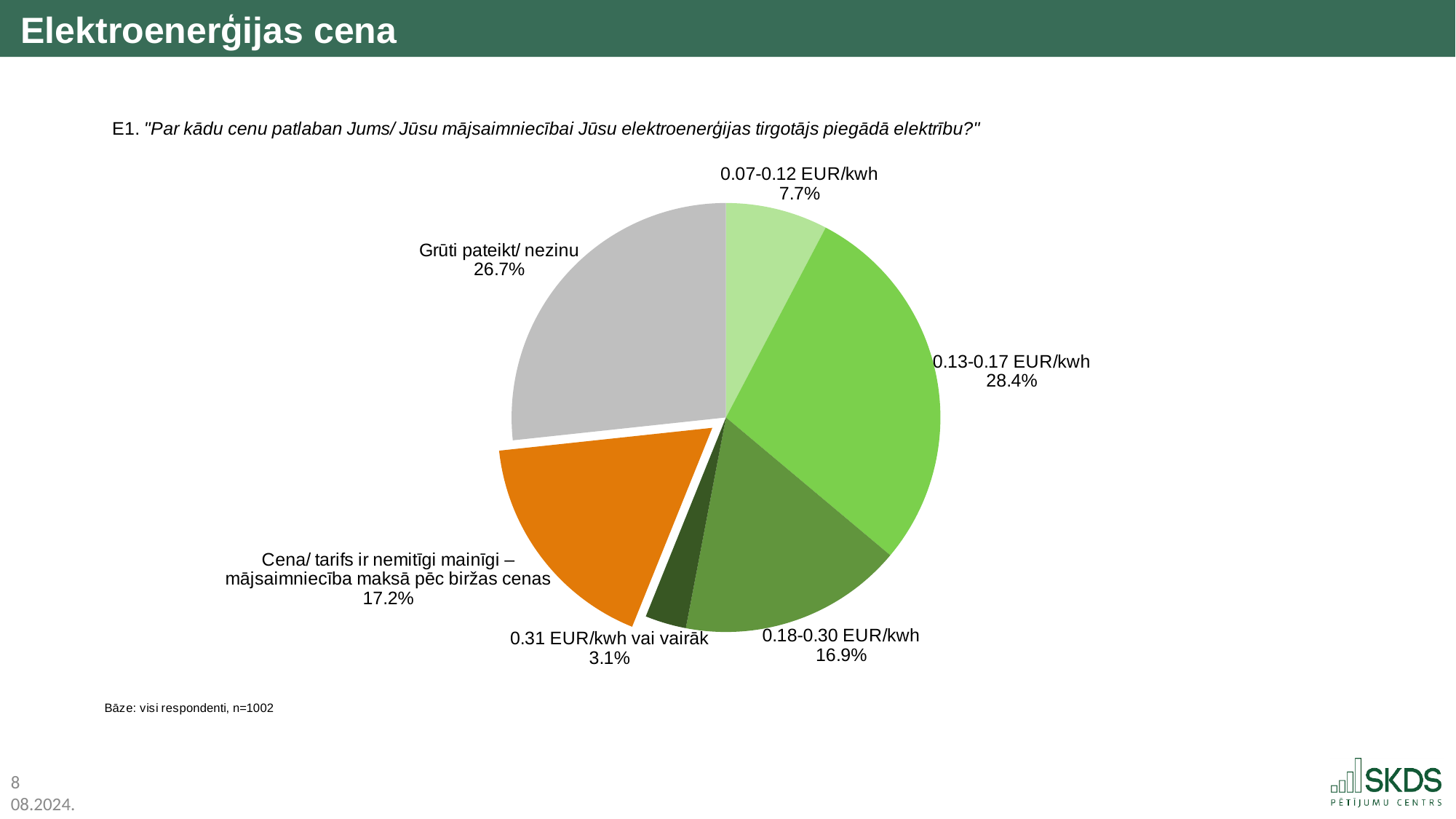
How many slices does the pie chart have? 6 Which category has the largest share of the pie? 0.13-0.17 EUR/kwh What share of respondents pay 0.31 EUR/kwh vai vairāk? 3.1% What share of respondents pay 0.13-0.17 EUR/kwh? 28.4% What type of chart is shown on the slide? Pie chart Which is larger: the share for 0.18-0.30 EUR/kwh or the share for 'Cena/ tarifs ir nemitīgi mainīgi – mājsaimniecība maksā pēc biržas cenas'? Cena/ tarifs ir nemitīgi mainīgi – mājsaimniecība maksā pēc biržas cenas What percentage of respondents pay 0.18-0.30 EUR/kwh? 16.9% Which category has the smallest share of the pie? 0.31 EUR/kwh vai vairāk What percentage of respondents answered 'Grūti pateikt/ nezinu'? 26.7% What is the combined share of the 0.07-0.12 EUR/kwh and 0.13-0.17 EUR/kwh slices? 36.1% What is the difference in percentage points between the 0.13-0.17 EUR/kwh slice and the 0.07-0.12 EUR/kwh slice? 20.7 Which slice is pulled out (exploded) from the pie? Cena/ tarifs ir nemitīgi mainīgi – mājsaimniecība maksā pēc biržas cenas